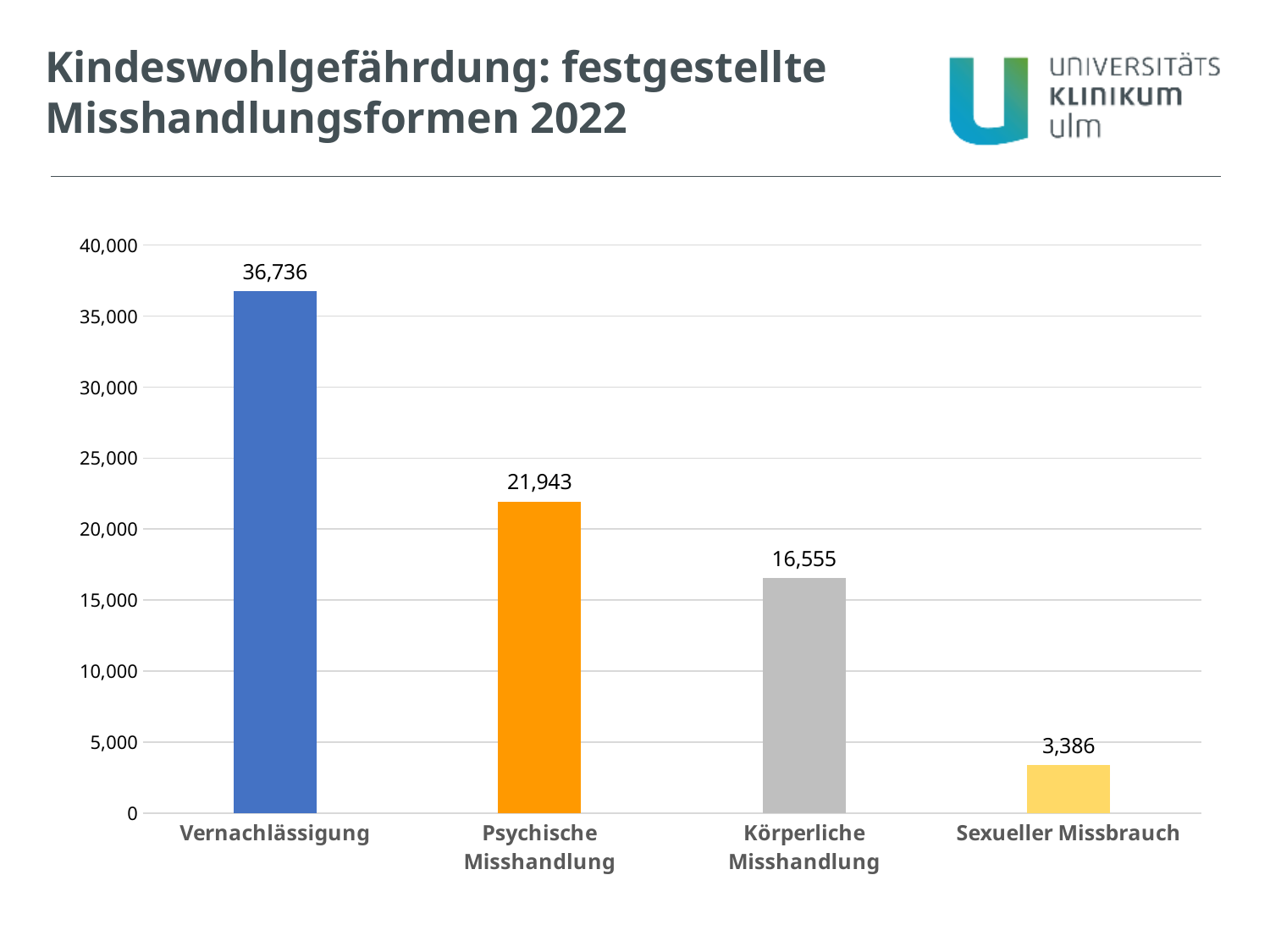
Which is larger, the value for Körperliche Misshandlung or the value for Sexueller Missbrauch? Körperliche Misshandlung Is the value for Körperliche Misshandlung greater or less than 20,000? less What is the value for Vernachlässigung? 36,736 Which category has the highest value? Vernachlässigung What is the difference between the values for Vernachlässigung and Psychische Misshandlung? 14,793 What is the value for Sexueller Missbrauch? 3,386 What is the value for Körperliche Misshandlung? 16,555 Which category has the lowest value? Sexueller Missbrauch What kind of chart is shown on the slide? bar chart What is the value for Psychische Misshandlung? 21,943 What is the difference between the values for Psychische Misshandlung and Körperliche Misshandlung? 5,388 How many categories are shown in the chart? 4